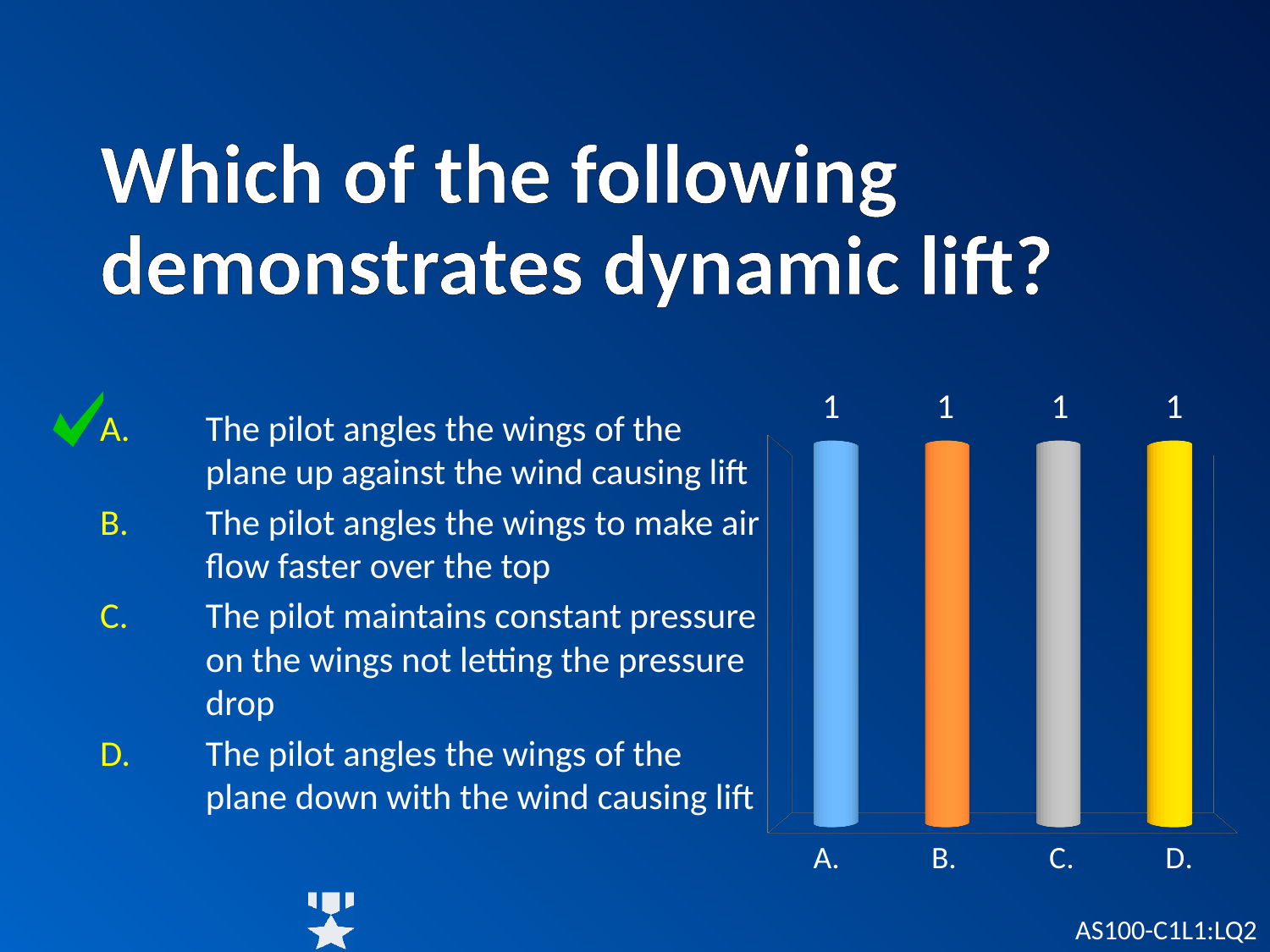
What is the value of the bar for category A.? 1 What colour is the bar for category B.? Orange What is the difference between the values for B. and C.? 0 What kind of chart is shown on the slide? Bar chart What is the value of the bar for category C.? 1 What is the value of the bar for category D.? 1 Do the bar values rise, fall, or stay the same from A. to D.? Stay the same What colour is the bar for category D.? Yellow What is the value of the bar for category B.? 1 What is the difference between the values for A. and D.? 0 How many bars are shown in the chart? 4